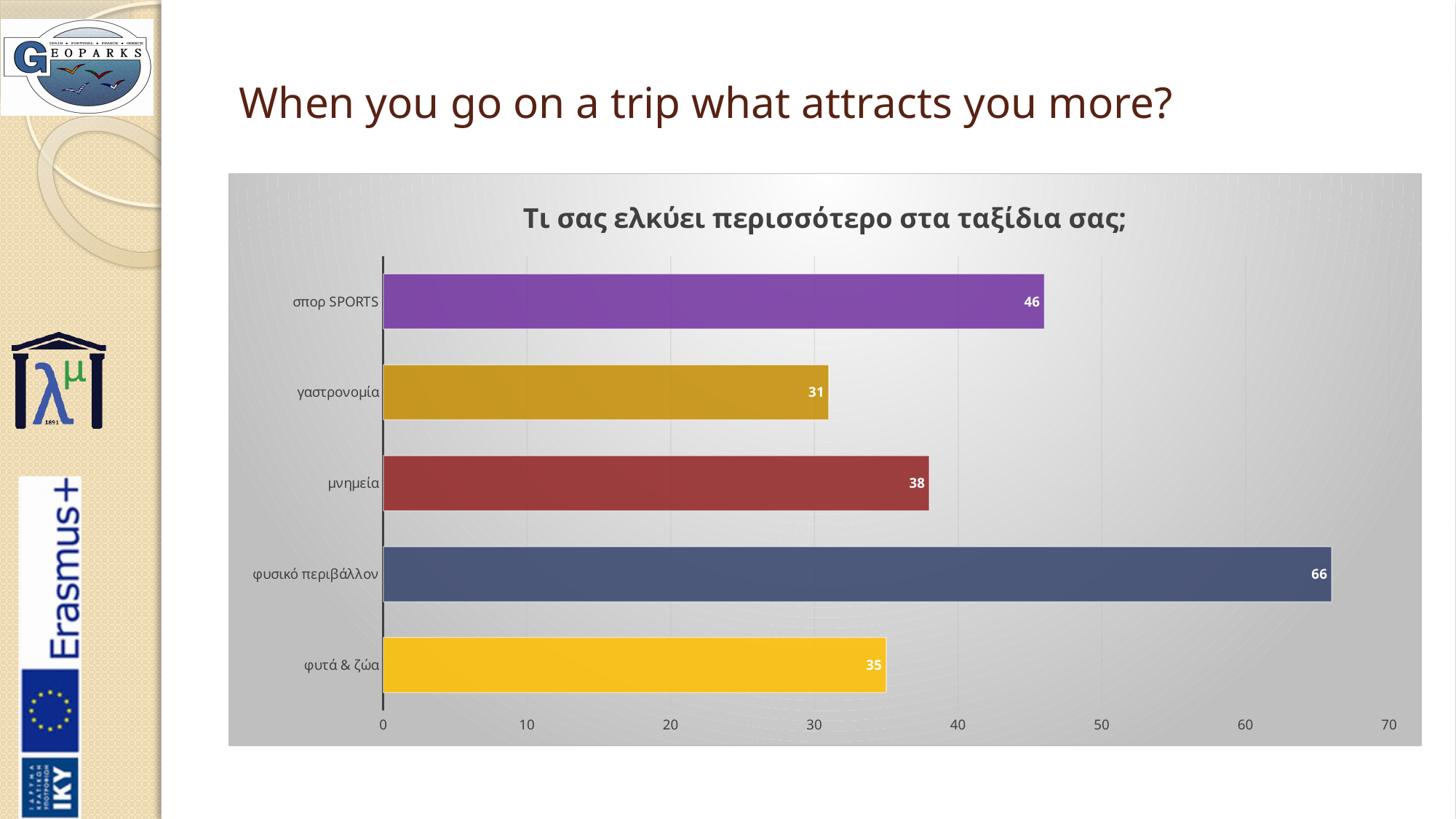
What is the value for φυσικό περιβάλλον? 66 What is the title of the chart? Τι σας ελκύει περισσότερο στα ταξίδια σας; What is the value for σπορ SPORTS? 46 What is the difference between the values for φυσικό περιβάλλον and σπορ SPORTS? 20 Which category has the lowest value? γαστρονομία How many categories are shown in the chart? 5 What is the value for γαστρονομία? 31 Which category has the highest value? φυσικό περιβάλλον What is the value for φυτά & ζώα? 35 What kind of chart is shown on the slide? bar chart Which is larger, the value for μνημεία or the value for φυτά & ζώα? μνημεία What is the value for μνημεία? 38